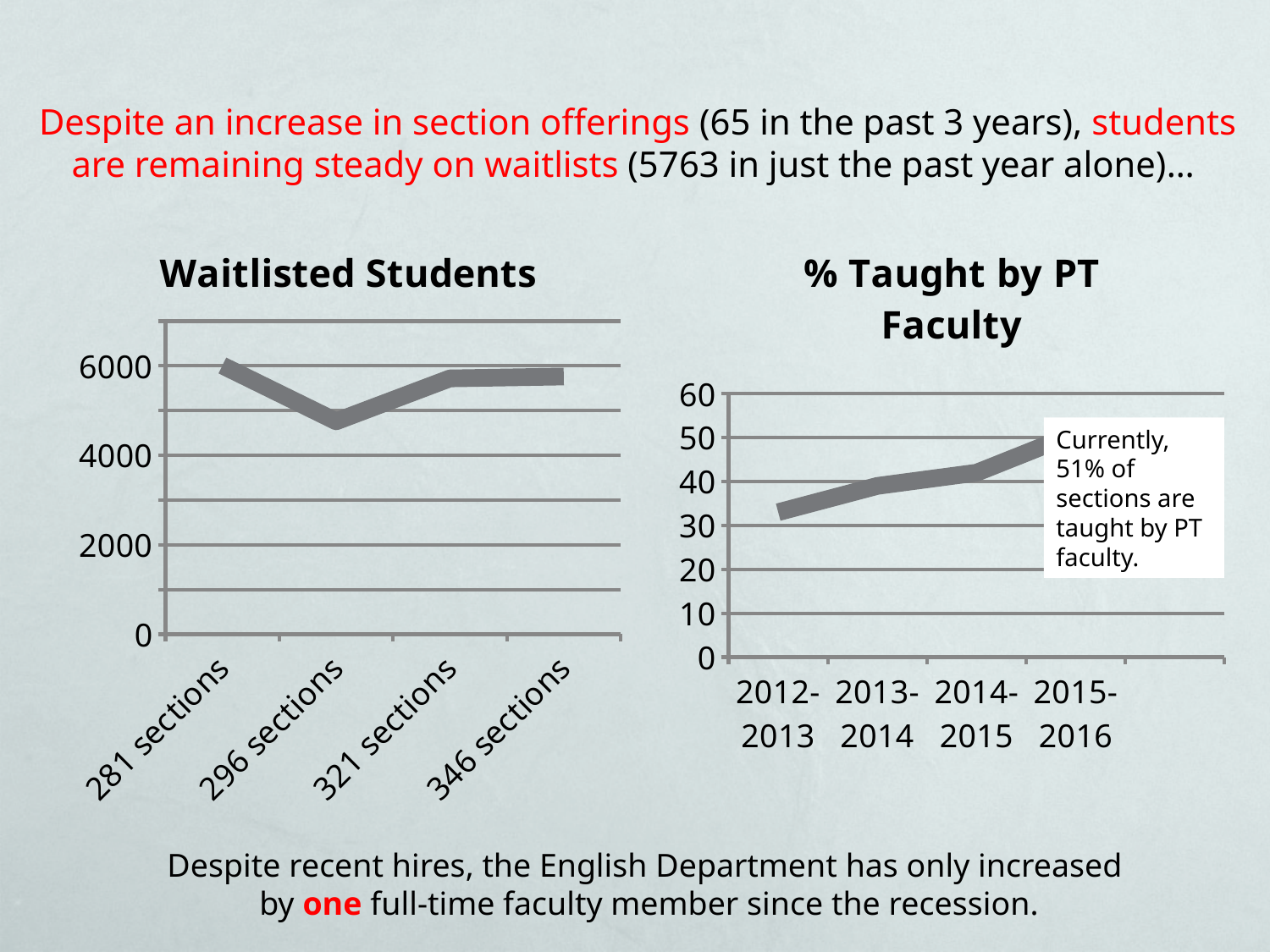
In the "Waitlisted Students" chart, is the value for 281 sections greater or less than 4000? greater In the "Waitlisted Students" chart, is the value for 346 sections greater or less than 4000? greater How many academic years are plotted in the "% Taught by PT Faculty" chart? 4 According to the text box on the "% Taught by PT Faculty" chart, what percentage of sections are currently taught by PT faculty? 51% In the "Waitlisted Students" chart, which category has the lowest value? 296 sections What kind of chart is the "Waitlisted Students" chart? line chart In the "% Taught by PT Faculty" chart, which year has the highest value? 2015-2016 In the "% Taught by PT Faculty" chart, is the value for 2012-2013 greater or less than 40? less In the "% Taught by PT Faculty" chart, do the values rise or fall from 2012-2013 to 2015-2016? rise How many categories are shown on the x axis of the "Waitlisted Students" chart? 4 In the "Waitlisted Students" chart, which is larger: the value for 281 sections or the value for 296 sections? 281 sections What kind of chart is the "% Taught by PT Faculty" chart? line chart